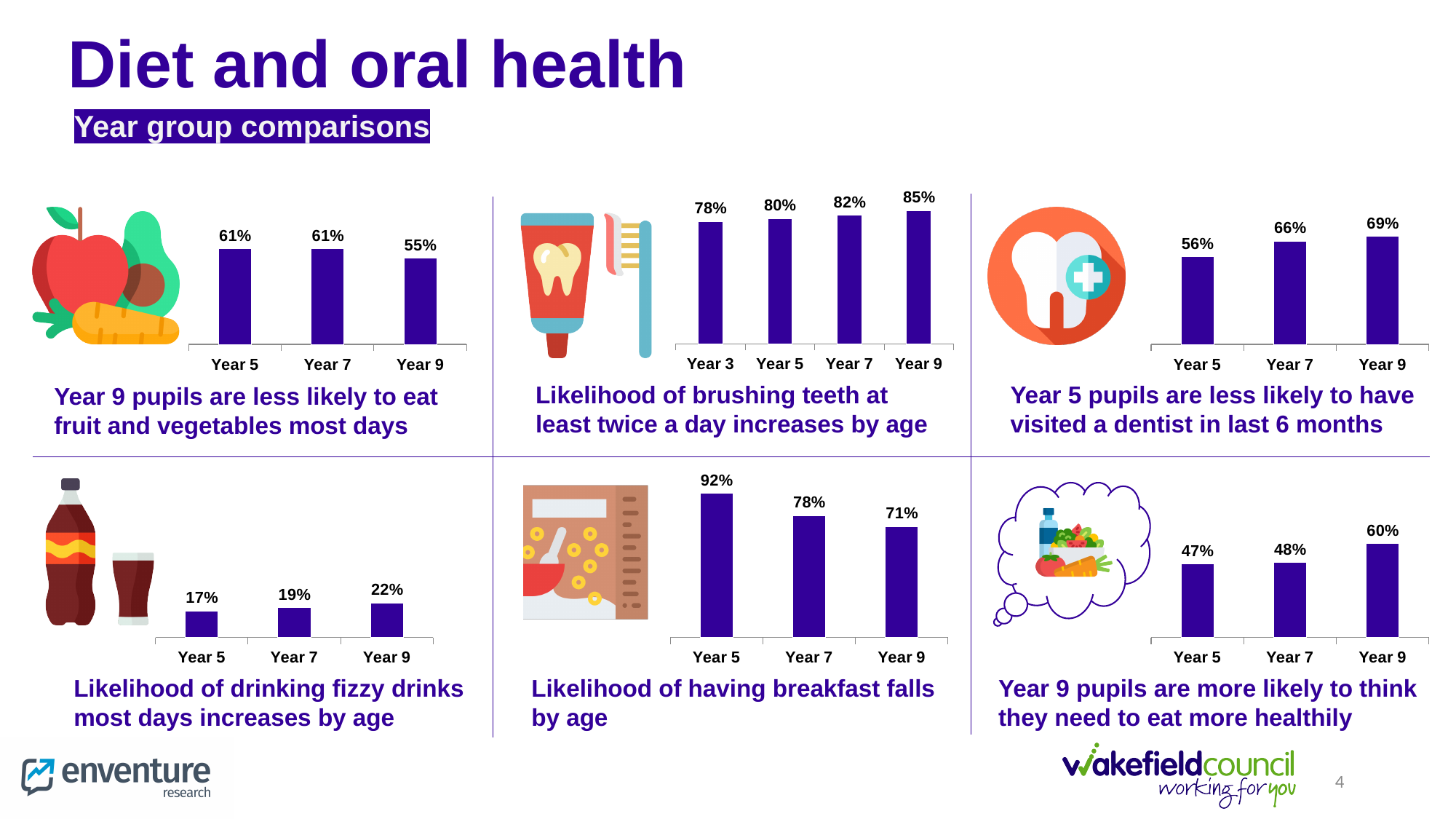
In the bottom-middle chart (having breakfast), what is the value for Year 5? 92% In the top-middle chart (brushing teeth at least twice a day), how many year groups are shown? 4 In the bottom-right chart (think they need to eat more healthily), which is larger, Year 7 or Year 9? Year 9 In the bottom-middle chart (having breakfast), what is the difference between Year 5 and Year 9? 21% In the top-middle chart (brushing teeth at least twice a day), which year group has the highest value? Year 9 In the top-left chart (eating fruit and vegetables most days), what is the value for Year 9? 55% In the top-right chart (visited a dentist in last 6 months), which year group has the lowest value? Year 5 In the bottom-left chart (drinking fizzy drinks most days), do the values rise or fall from Year 5 to Year 9? rise What kind of chart is used in the bottom-right panel (think they need to eat more healthily)? bar chart How many charts are shown on the slide? 6 In the top-right chart (visited a dentist in last 6 months), what is the difference between Year 9 and Year 5? 13% In the bottom-left chart (drinking fizzy drinks most days), what is the value for Year 7? 19%